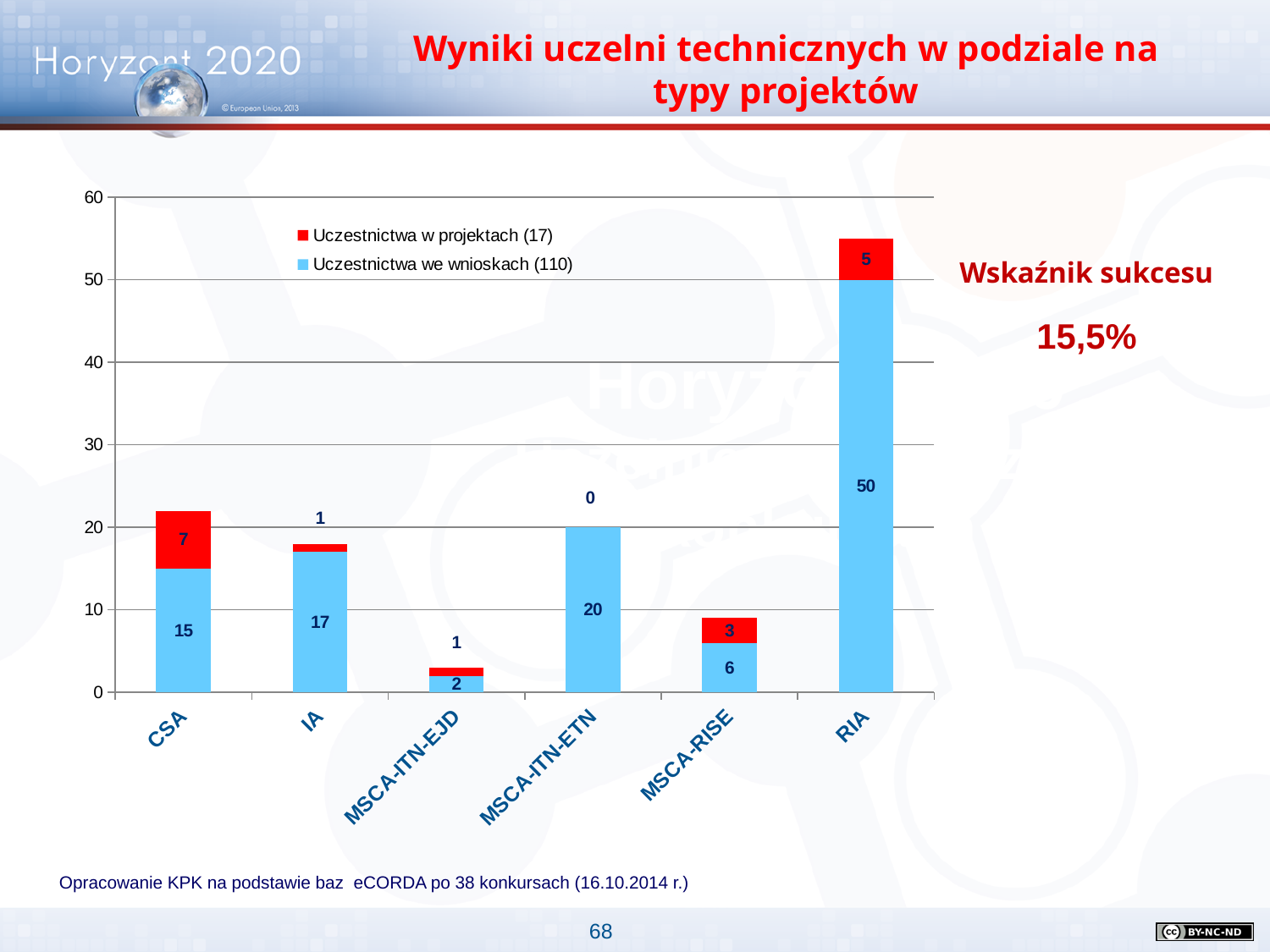
What is the value of 'Uczestnictwa we wnioskach' for RIA? 50 What is the value of 'Uczestnictwa w projektach' for CSA? 7 Which category has the lowest value for 'Uczestnictwa we wnioskach'? MSCA-ITN-EJD What kind of chart is shown on the slide? stacked bar chart Which category has the highest value for 'Uczestnictwa we wnioskach'? RIA What is the difference between the 'Uczestnictwa we wnioskach' values for RIA and MSCA-ITN-ETN? 30 What is the total of the stacked bar for MSCA-RISE? 9 How many categories are shown on the x axis of the chart? 6 What is the value of 'Uczestnictwa w projektach' for MSCA-ITN-ETN? 0 What success rate (Wskaźnik sukcesu) is stated next to the chart? 15,5% Which is larger: the 'Uczestnictwa w projektach' value for CSA or for MSCA-RISE? CSA How many series does the chart's legend list? 2